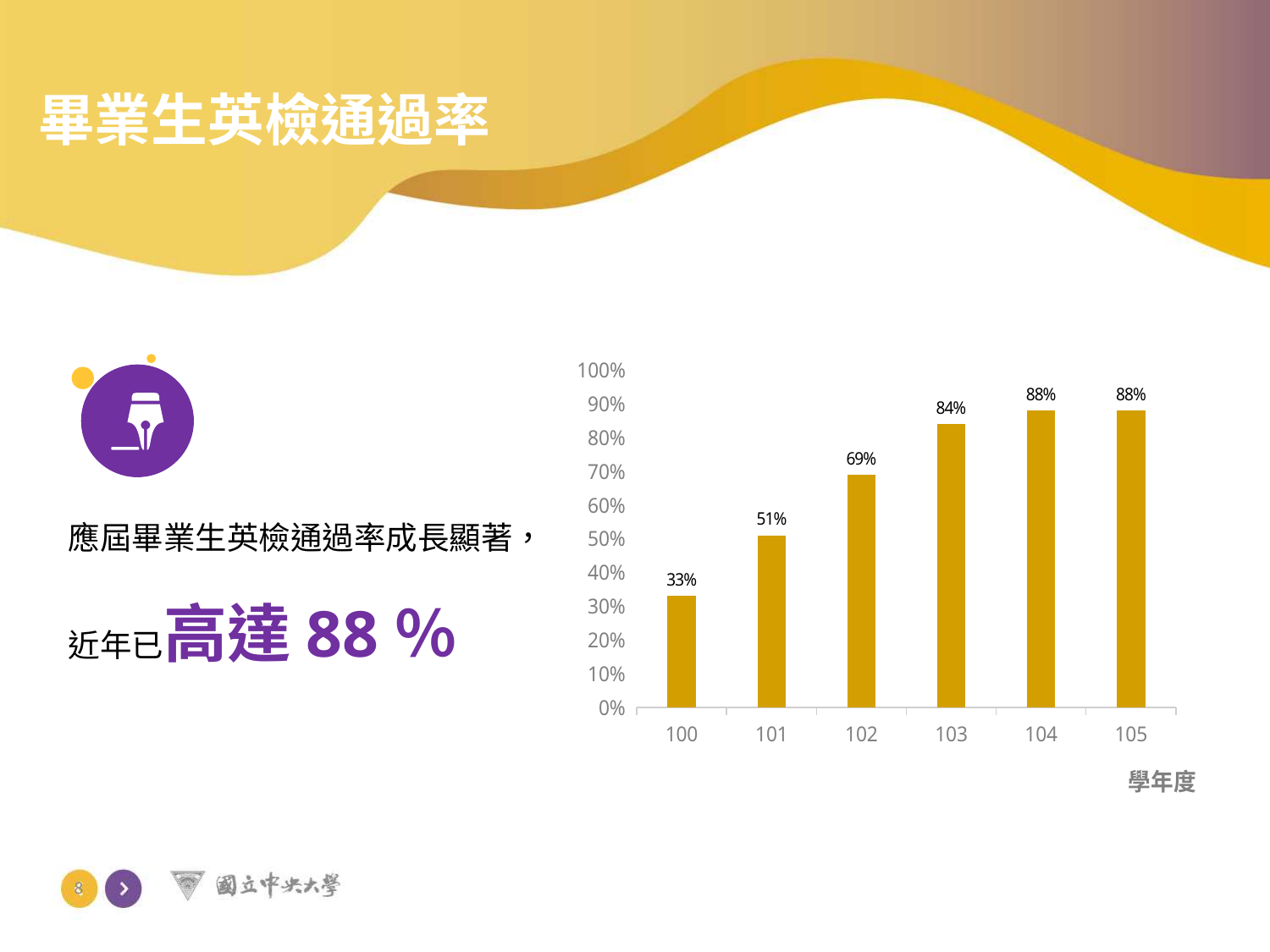
What is the label of the x axis of the chart? 學年度 Which has a higher pass rate, academic year 101 or academic year 102? 102 What is the highest pass rate shown in the chart? 88% What kind of chart is shown on the slide? Bar chart What is the difference in pass rate between academic year 101 and academic year 100? 18% What is the difference in pass rate between academic year 103 and academic year 102? 15% How many academic years are shown on the x axis of the chart? 6 Which academic year has the lowest pass rate? 100 What is the pass rate shown for academic year 103? 84% Do the pass rates generally rise or fall from academic year 100 to 105? Rise What is the pass rate shown for academic year 102? 69% What is the English proficiency test pass rate for academic year 100? 33%